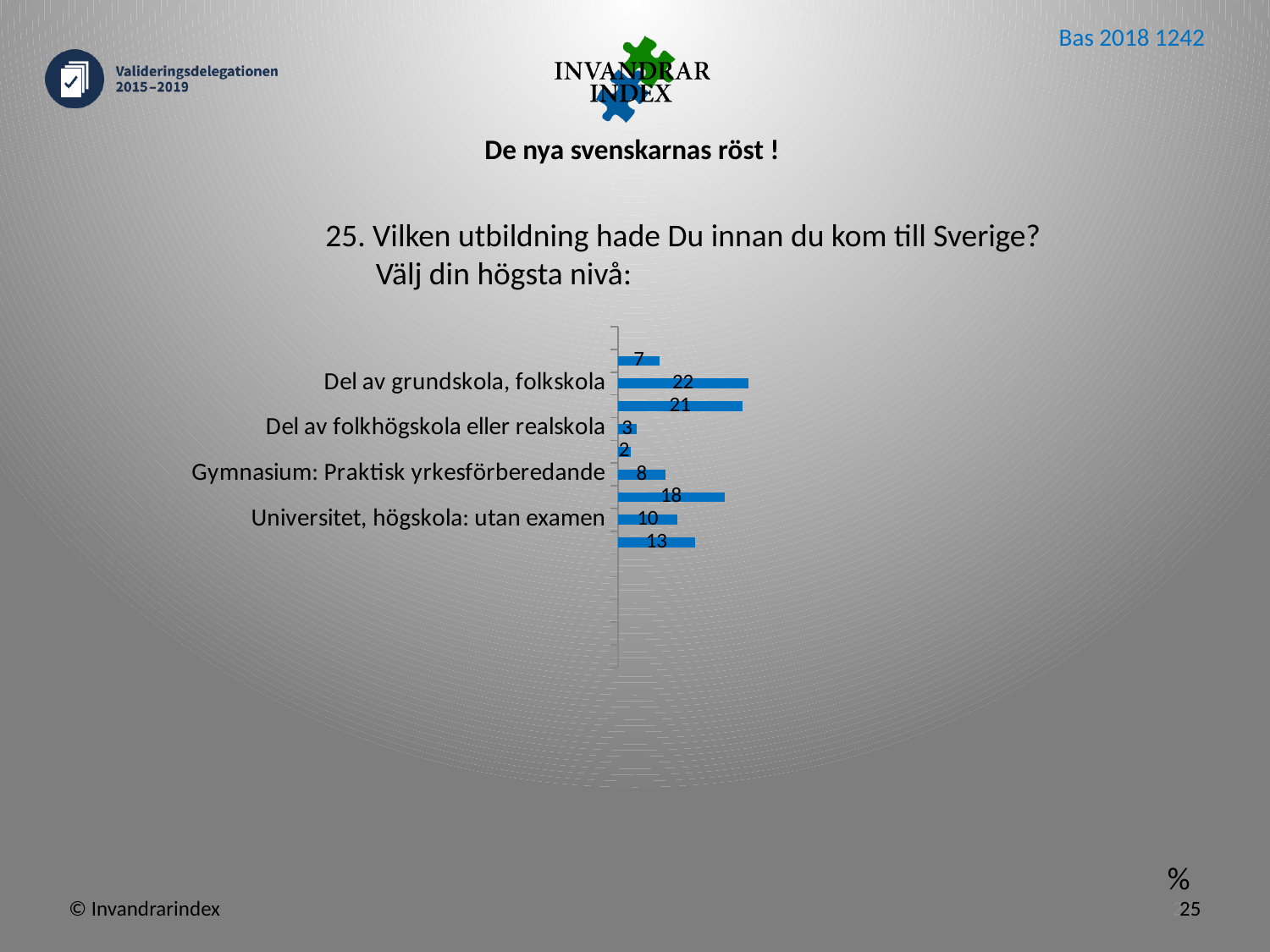
What type of chart is shown on the slide? bar chart What is the value for "Del av folkhögskola eller realskola"? 3 What is the difference between the values for "Del av grundskola, folkskola" and "Universitet, högskola: utan examen"? 12 How many bars are plotted in the chart? 9 What question number is the chart about, according to the heading above it? 25 What is the highest value shown in the chart? 22 Which has the larger value: "Gymnasium: Praktisk yrkesförberedande" or "Universitet, högskola: utan examen"? Universitet, högskola: utan examen What is the lowest value shown in the chart? 2 What is the value for "Del av grundskola, folkskola"? 22 What is the value for "Universitet, högskola: utan examen"? 10 Which labelled category has the highest value? Del av grundskola, folkskola What is the value for "Gymnasium: Praktisk yrkesförberedande"? 8